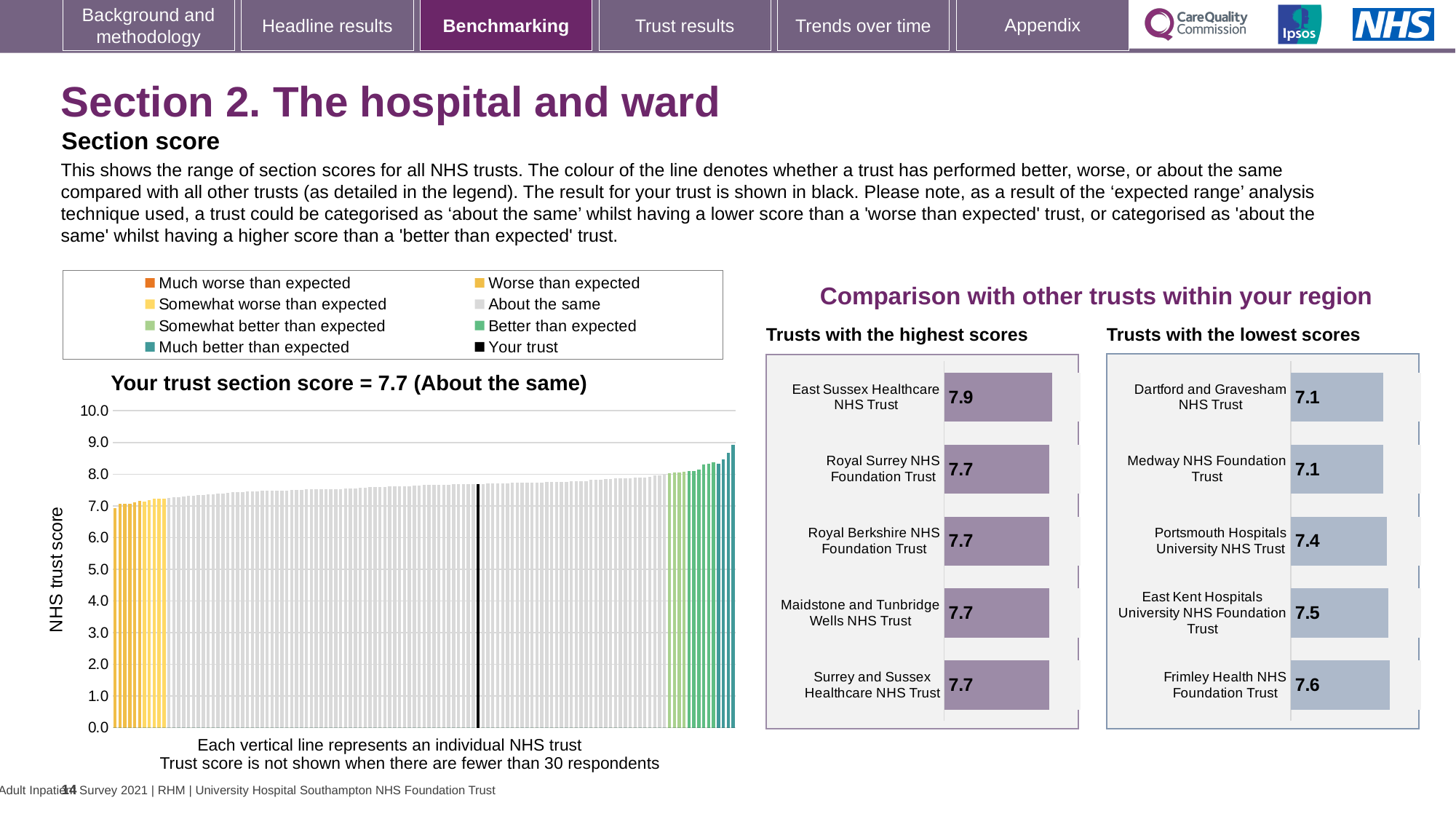
In the main chart on the left, do the bar values rise or fall from left to right? rise In the 'Trusts with the lowest scores' chart, which trust has the highest score? Frimley Health NHS Foundation Trust What kind of chart is the main chart on the left titled 'Your trust section score = 7.7 (About the same)'? bar chart In the 'Trusts with the highest scores' chart, what is the score for East Sussex Healthcare NHS Trust? 7.9 In the 'Trusts with the highest scores' chart, which trust has the highest score? East Sussex Healthcare NHS Trust In the 'Trusts with the lowest scores' chart, which has the larger score: Portsmouth Hospitals University NHS Trust or East Kent Hospitals University NHS Foundation Trust? East Kent Hospitals University NHS Foundation Trust In the main chart on the left, is the value for your trust (the black bar) greater or less than 7.0? greater What is the section score for your trust shown in the title of the main chart on the left? 7.7 How many trusts are listed in the 'Trusts with the lowest scores' chart? 5 In the 'Trusts with the highest scores' chart, what is the difference between the scores of East Sussex Healthcare NHS Trust and Royal Surrey NHS Foundation Trust? 0.2 In the 'Trusts with the lowest scores' chart, what is the score for Portsmouth Hospitals University NHS Trust? 7.4 In the 'Trusts with the lowest scores' chart, what is the difference between the scores of Frimley Health NHS Foundation Trust and Dartford and Gravesham NHS Trust? 0.5